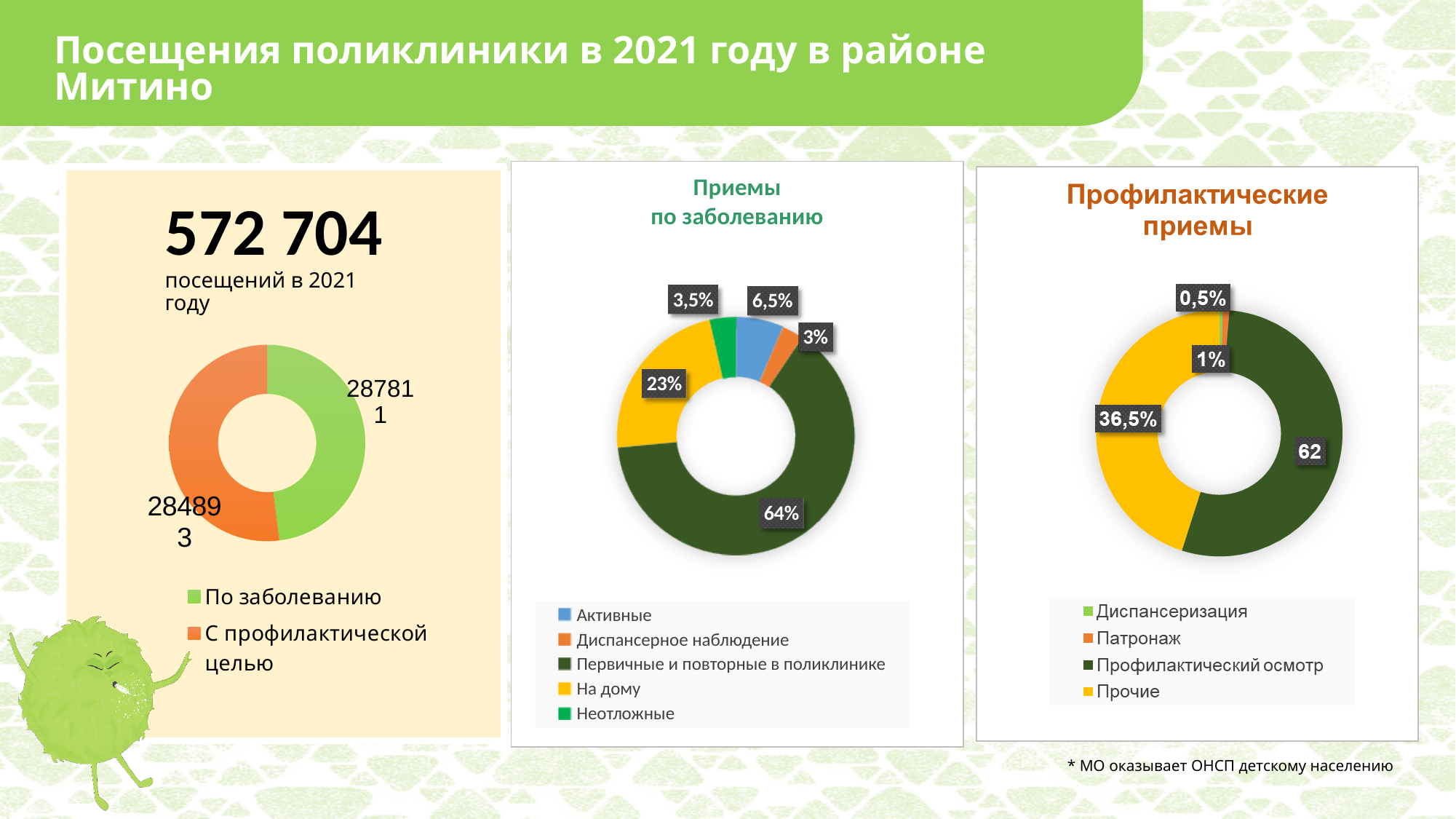
On the chart titled "Приемы по заболеванию", how many categories does the legend list? 5 On the chart titled "Профилактические приемы", what value is shown for "Прочие"? 36,5% On the chart titled "Приемы по заболеванию", which category has the smallest share? Диспансерное наблюдение On the left chart in the yellow panel, what value is shown for "По заболеванию"? 287811 On the chart titled "Профилактические приемы", what value is shown for "Патронаж"? 1% What kind of chart is the chart titled "Профилактические приемы"? Donut chart On the chart titled "Приемы по заболеванию", what is the difference between the shares for "На дому" and "Активные"? 16,5% On the chart titled "Профилактические приемы", which category has the largest share? Профилактический осмотр On the chart titled "Приемы по заболеванию", what share is shown for "Активные"? 6,5% On the chart titled "Профилактические приемы", which is larger: the share for "Диспансеризация" or for "Патронаж"? Патронаж On the chart titled "Приемы по заболеванию", what share is shown for "Первичные и повторные в поликлинике"? 64% On the chart titled "Приемы по заболеванию", what share is shown for "На дому"? 23%